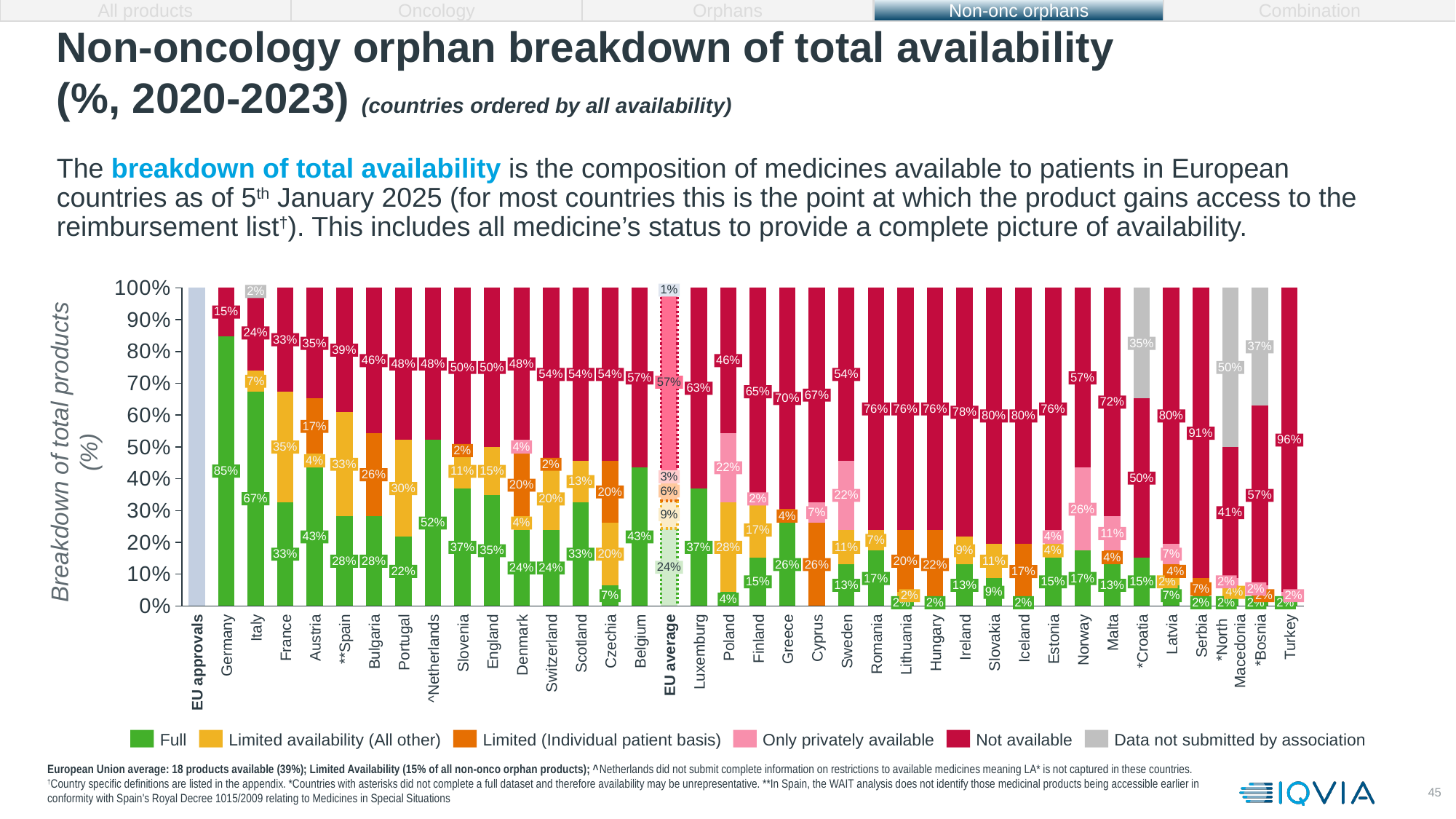
What is the 'Full' availability value for the EU average bar? 24% What is the 'Not available' value for Turkey? 96% How many bars (categories) are plotted along the x axis? 38 What is the 'Data not submitted by association' value for *Croatia? 35% Which has the larger 'Not available' share, France or **Spain? **Spain How many series does the legend list? 6 What is the difference in 'Full' availability between Germany and Italy? 18 percentage points Which colour represents 'Not available' in the legend? Red What is the 'Full' availability value for Germany? 85% What is the 'Only privately available' value for Poland? 22% What kind of chart is shown on the slide? Stacked bar chart Which country has the highest 'Full' availability share? Germany